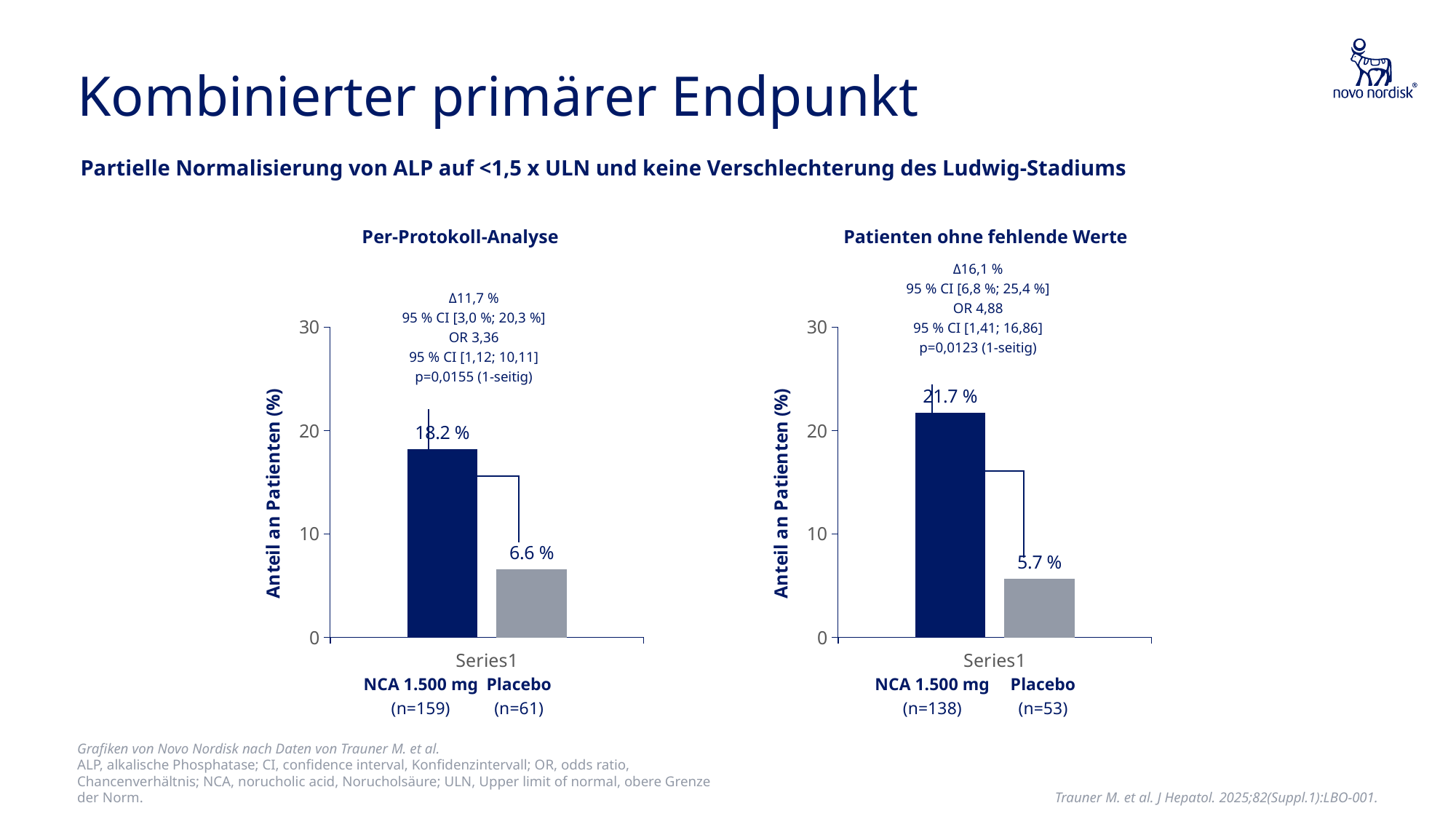
In the Per-Protokoll-Analyse chart, what is the value for NCA 1.500 mg? 18.2 % In the Patienten ohne fehlende Werte chart, which group has the lowest value? Placebo In the Patienten ohne fehlende Werte chart, what is the value for Placebo? 5.7 % What is the y-axis label of the Patienten ohne fehlende Werte chart? Anteil an Patienten (%) In the Per-Protokoll-Analyse chart, what is the Δ value printed above the bars? Δ11,7 % How many bars are shown in the Patienten ohne fehlende Werte chart? 2 In the Per-Protokoll-Analyse chart, what is the value for Placebo? 6.6 % What kind of chart is the Per-Protokoll-Analyse chart? bar chart In the Per-Protokoll-Analyse chart, is the value for Placebo greater or less than 10? less In the Patienten ohne fehlende Werte chart, is the value for NCA 1.500 mg greater or less than 20? greater In the Patienten ohne fehlende Werte chart, what is the value for NCA 1.500 mg? 21.7 % In the Per-Protokoll-Analyse chart, which group has the higher value? NCA 1.500 mg